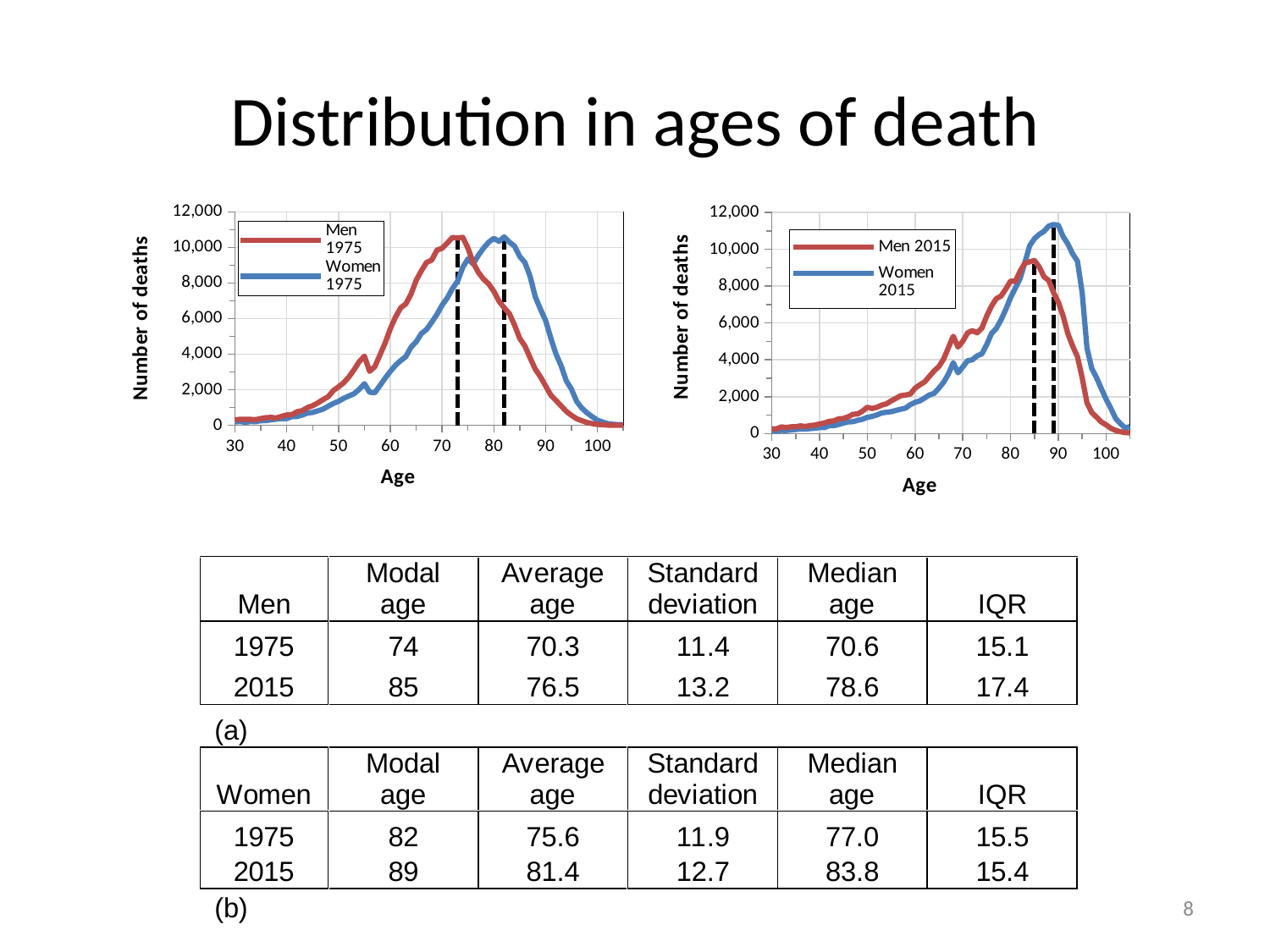
In the right chart (2015), is the peak value of the Men 2015 line greater or less than 10,000? less In the left chart (1975), does the Men 1975 line generally rise or fall between age 40 and age 70? rise In the left chart (1975), what are the two series named in the legend? Men 1975 and Women 1975 In the right chart (2015), is the value of the Men 2015 line at age 50 greater or less than 4,000? less In the right chart (2015), which series reaches the higher peak number of deaths, Men 2015 or Women 2015? Women 2015 In the left chart (1975), which series peaks at an older age, Men 1975 or Women 1975? Women 1975 In the right chart (2015), is the peak value of the Women 2015 line greater or less than 10,000? greater What is the label on the vertical axis of the left chart (1975)? Number of deaths In the right chart (2015), does the Women 2015 line rise or fall between age 90 and age 100? fall What kind of chart is the left chart (1975)? line chart How many series does the legend of the right chart (2015) list? 2